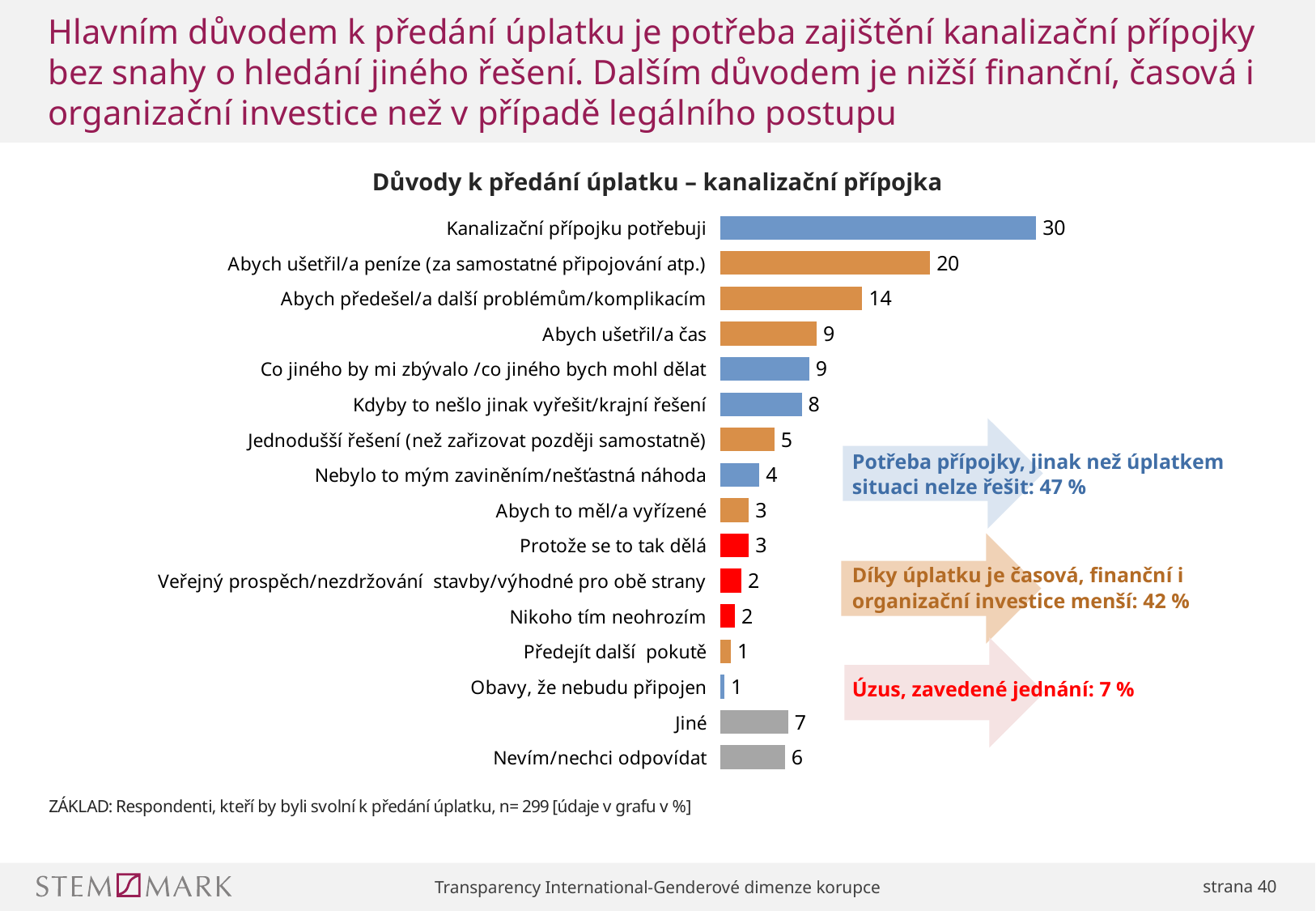
What is the value for "Kanalizační přípojku potřebuji"? 30 What is the value for "Nebylo to mým zaviněním/nešťastná náhoda"? 4 Which category has the highest value? Kanalizační přípojku potřebuji How many categories are plotted in the chart? 16 What is the value for "Jiné"? 7 What is the difference between the values for "Kanalizační přípojku potřebuji" and "Abych ušetřil/a peníze (za samostatné připojování atp.)"? 10 What is the difference between the values for "Jiné" and "Nevím/nechci odpovídat"? 1 What colour are the bars for "Protože se to tak dělá" and "Nikoho tím neohrozím"? red Which is larger: the value for "Kdyby to nešlo jinak vyřešit/krajní řešení" or the value for "Jednodušší řešení (než zařizovat později samostatně)"? Kdyby to nešlo jinak vyřešit/krajní řešení What type of chart is shown on the slide? bar chart What is the value for "Abych předešel/a další problémům/komplikacím"? 14 What is the title of the chart? Důvody k předání úplatku – kanalizační přípojka